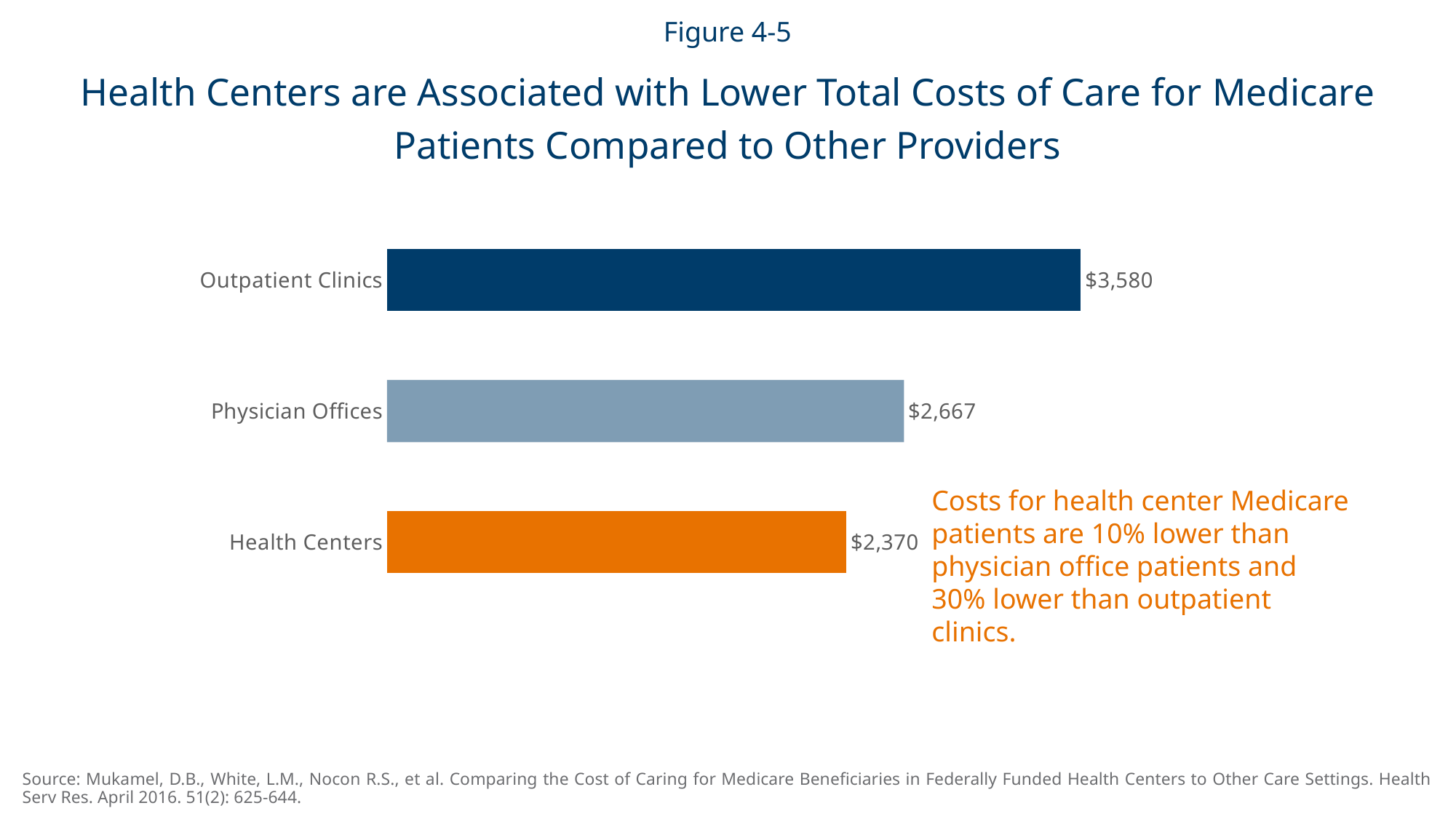
What is the value for Physician Offices? $2,667 What is the value for Health Centers? $2,370 Which is larger, the value for Physician Offices or the value for Health Centers? Physician Offices What is the difference between the values for Outpatient Clinics and Health Centers? $1,210 What kind of chart is shown on the slide? Bar chart How many categories are shown in the chart? 3 What is the figure number shown above the chart title? Figure 4-5 What is the value for Outpatient Clinics? $3,580 Which category has the highest value? Outpatient Clinics What colour is the bar for Health Centers? Orange What is the difference between the values for Physician Offices and Health Centers? $297 Which category has the lowest value? Health Centers